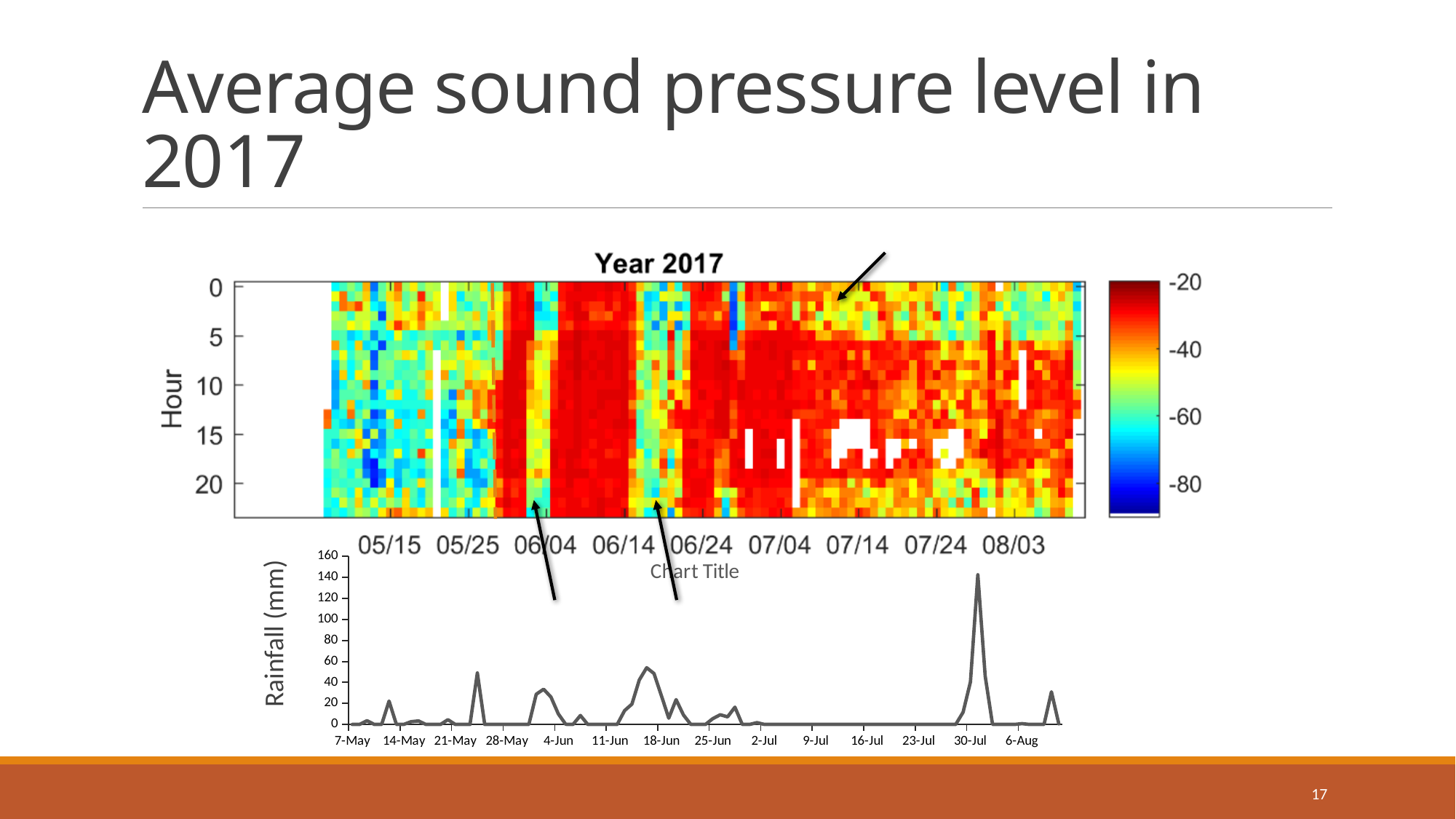
In the lower rainfall chart, is the value at the peak near 18-Jun greater or less than 40? greater In the lower rainfall chart, which peak is higher: the one near 30-Jul or the one near 18-Jun? 30-Jul In the lower rainfall chart, is the value at the peak near 18-Jun greater or less than 80? less In the lower rainfall chart, around which date does the highest rainfall peak occur? 30-Jul In the lower rainfall chart, is the value at the peak near 14-May greater or less than 40? less What is the y-axis label of the lower chart? Rainfall (mm) In the upper heatmap chart, what is the y-axis label? Hour What kind of chart is the lower chart titled "Chart Title"? line chart What is the maximum value shown on the y-axis of the lower rainfall chart? 160